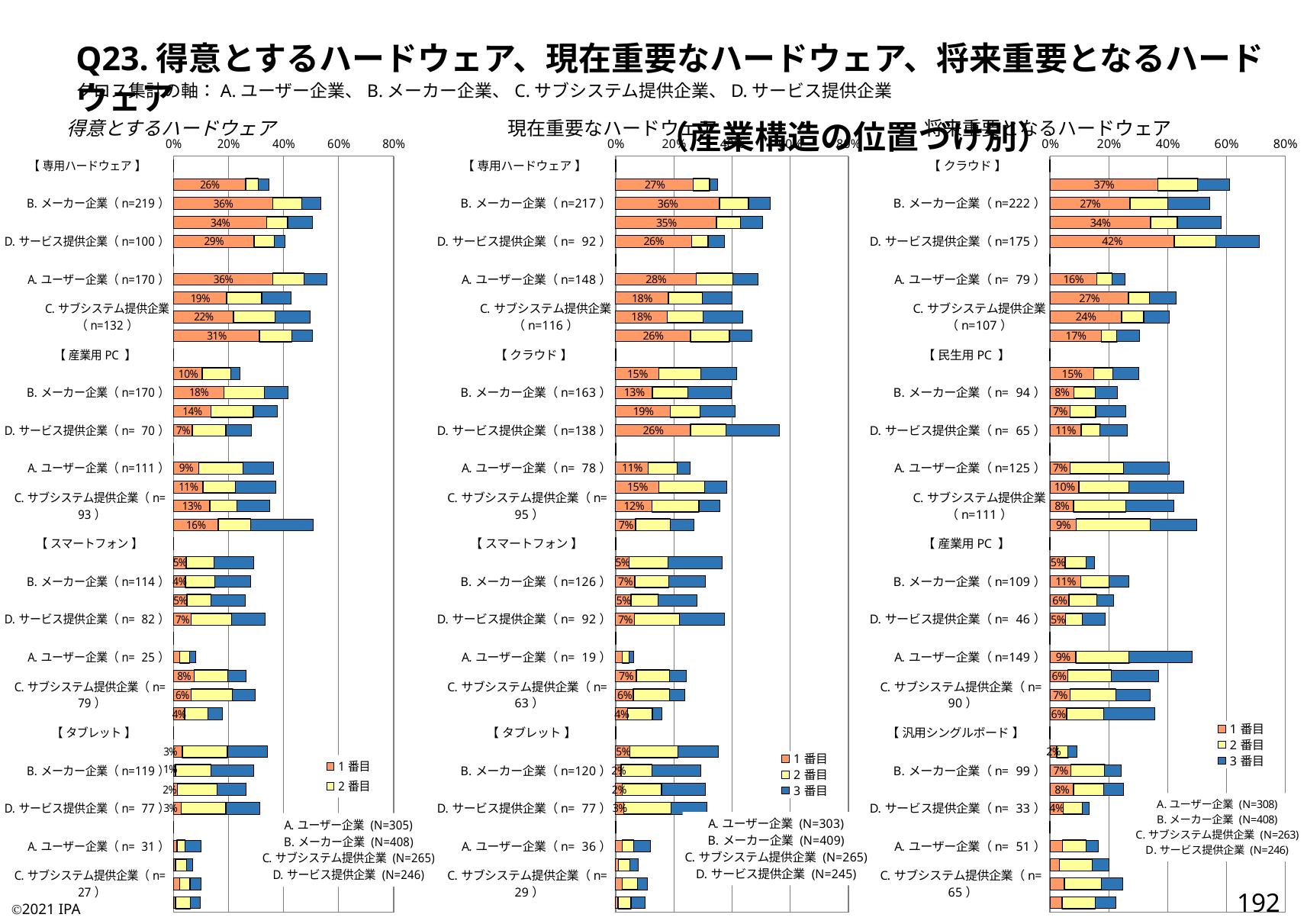
In the right chart (将来重要となるハードウェア), is the total bar length for D. サービス提供企業 (n=175) under クラウド greater or less than 60%? greater In the middle chart (現在重要なハードウェア), what is the 1番目 value for D. サービス提供企業 (n=138) under クラウド? 26% What kind of chart is the right chart (将来重要となるハードウェア)? Stacked horizontal bar chart In the middle chart (現在重要なハードウェア), what is the 1番目 value for B. メーカー企業 (n=217) under 専用ハードウェア? 36% In the right chart (将来重要となるハードウェア), under クラウド, what is the difference in 1番目 value between D. サービス提供企業 (n=175) and B. メーカー企業 (n=222)? 15 percentage points In the left chart (得意とするハードウェア), what is the 1番目 value for B. メーカー企業 (n=219) under 専用ハードウェア? 36% In the right chart (将来重要となるハードウェア), under クラウド, which has the larger 1番目 value: B. メーカー企業 (n=222) or D. サービス提供企業 (n=175)? D. サービス提供企業 (n=175) In the left chart (得意とするハードウェア), what is the 1番目 value for D. サービス提供企業 (n=100) under 専用ハードウェア? 29% In the left chart (得意とするハードウェア), what is the 1番目 value for D. サービス提供企業 (n=70) under 産業用PC? 7% In the right chart (将来重要となるハードウェア), what is the 1番目 value for D. サービス提供企業 (n=175) under クラウド? 42% How many series does the legend of the middle chart (現在重要なハードウェア) list? 3